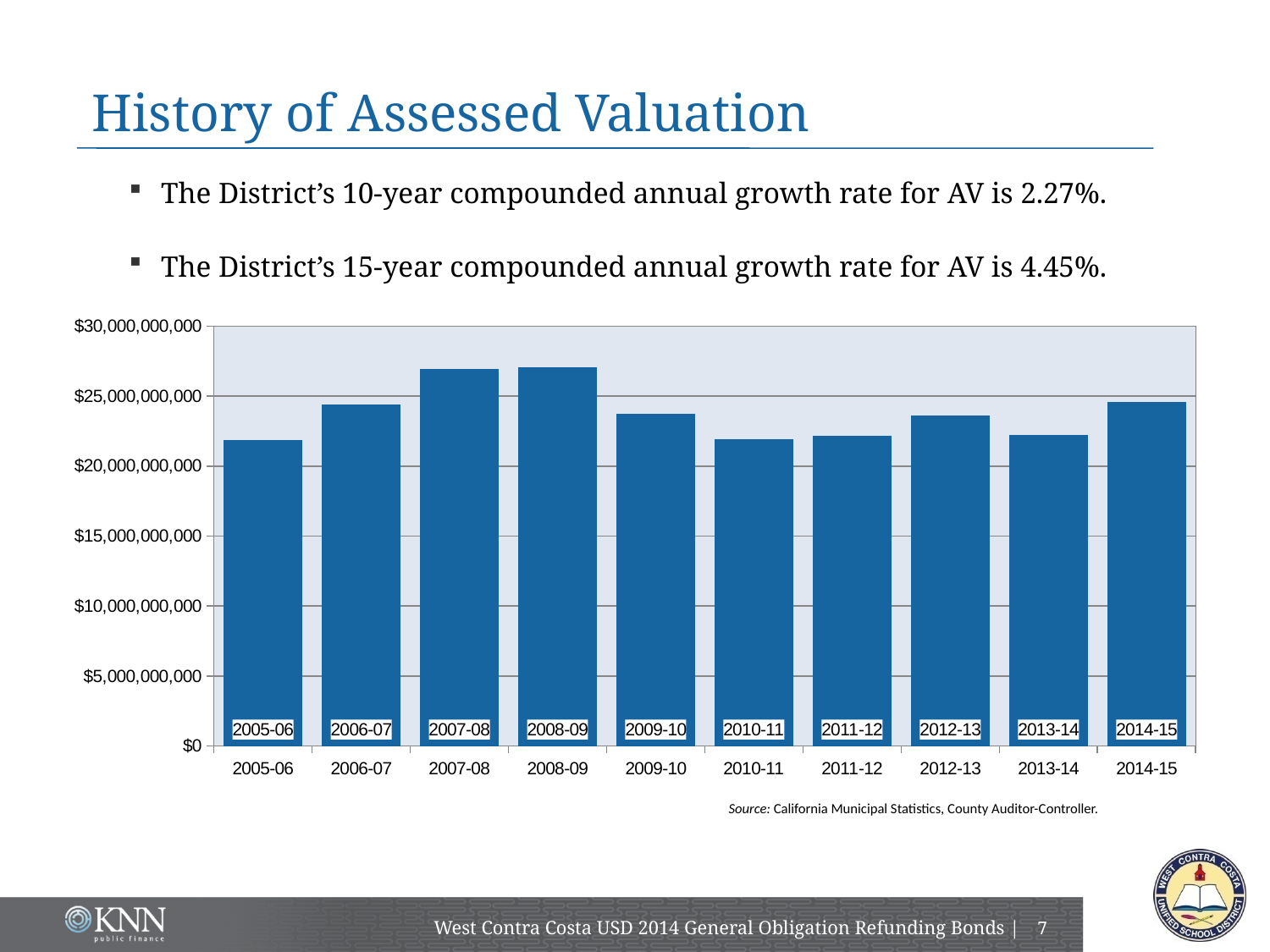
Which is larger, the value for 2007-08 or the value for 2009-10? 2007-08 What kind of chart is shown on the slide? bar chart Do the values rise or fall from 2005-06 to 2008-09? rise Is the value for 2010-11 greater or less than $25,000,000,000? less Is the value for 2005-06 greater or less than $25,000,000,000? less What is the highest value shown on the chart's vertical axis? $30,000,000,000 Do the values rise or fall from 2008-09 to 2010-11? fall Is the value for 2008-09 greater or less than $25,000,000,000? greater Which is larger, the value for 2012-13 or the value for 2013-14? 2012-13 How many fiscal years are plotted in the chart? 10